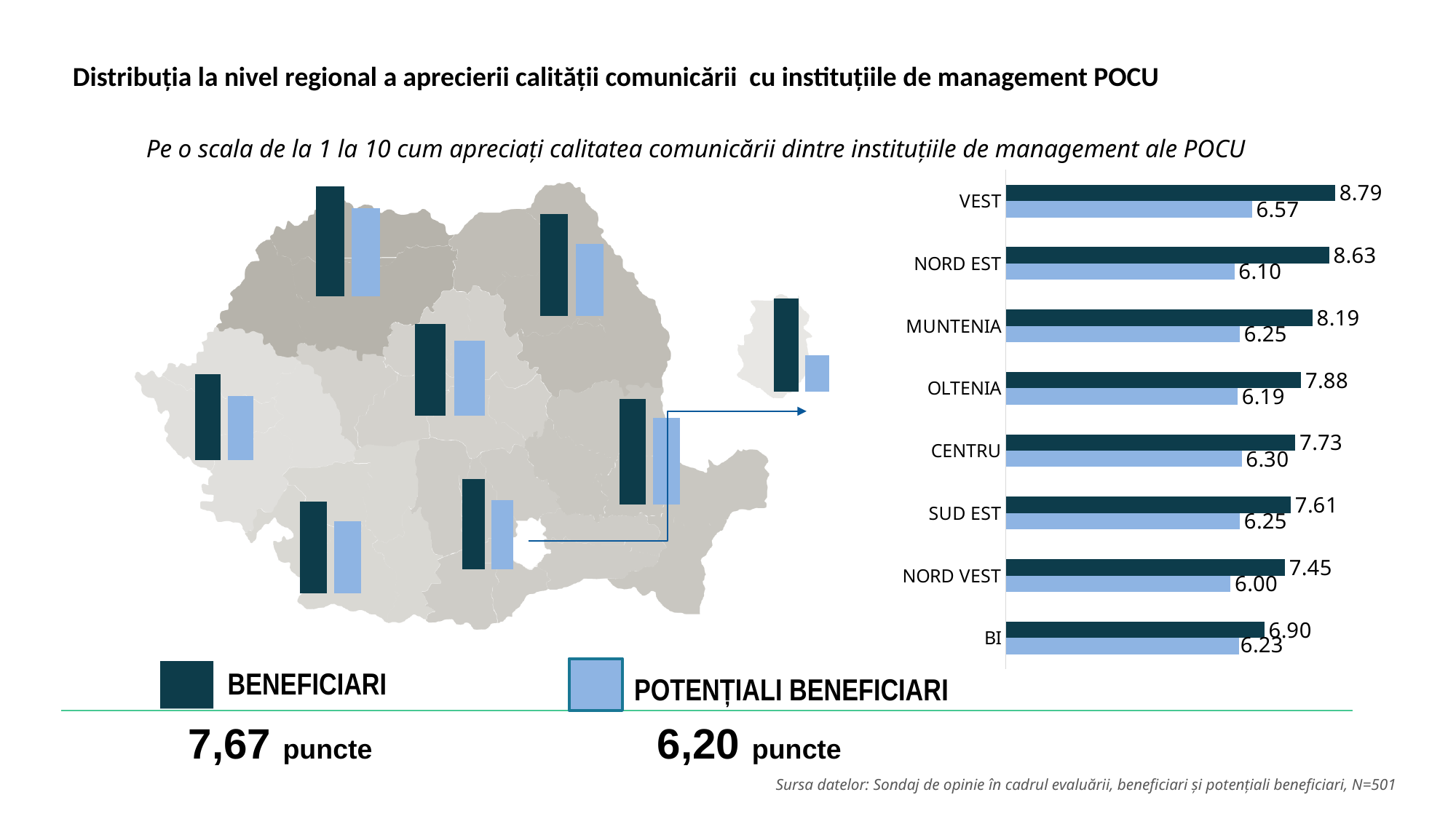
In the bar chart on the right, what is the POTENȚIALI BENEFICIARI value for NORD EST? 6.10 In the bar chart on the right, which region has the highest BENEFICIARI value? VEST In the bar chart on the right, what is the BENEFICIARI value for BI? 6.90 In the bar chart on the right, what is the difference between the BENEFICIARI values for VEST and BI? 1.89 What kind of chart is shown on the right of the slide? Bar chart In the bar chart on the right, what is the difference between the BENEFICIARI and POTENȚIALI BENEFICIARI values for VEST? 2.22 Which series is shown in dark colour in the bar chart on the right? BENEFICIARI In the bar chart on the right, which region has the lowest POTENȚIALI BENEFICIARI value? NORD VEST How many regions are shown in the bar chart on the right? 8 In the bar chart on the right, which is larger: the POTENȚIALI BENEFICIARI value for CENTRU or for OLTENIA? CENTRU In the bar chart on the right, what is the BENEFICIARI value for VEST? 8.79 How many series does the legend list for the bar chart? 2